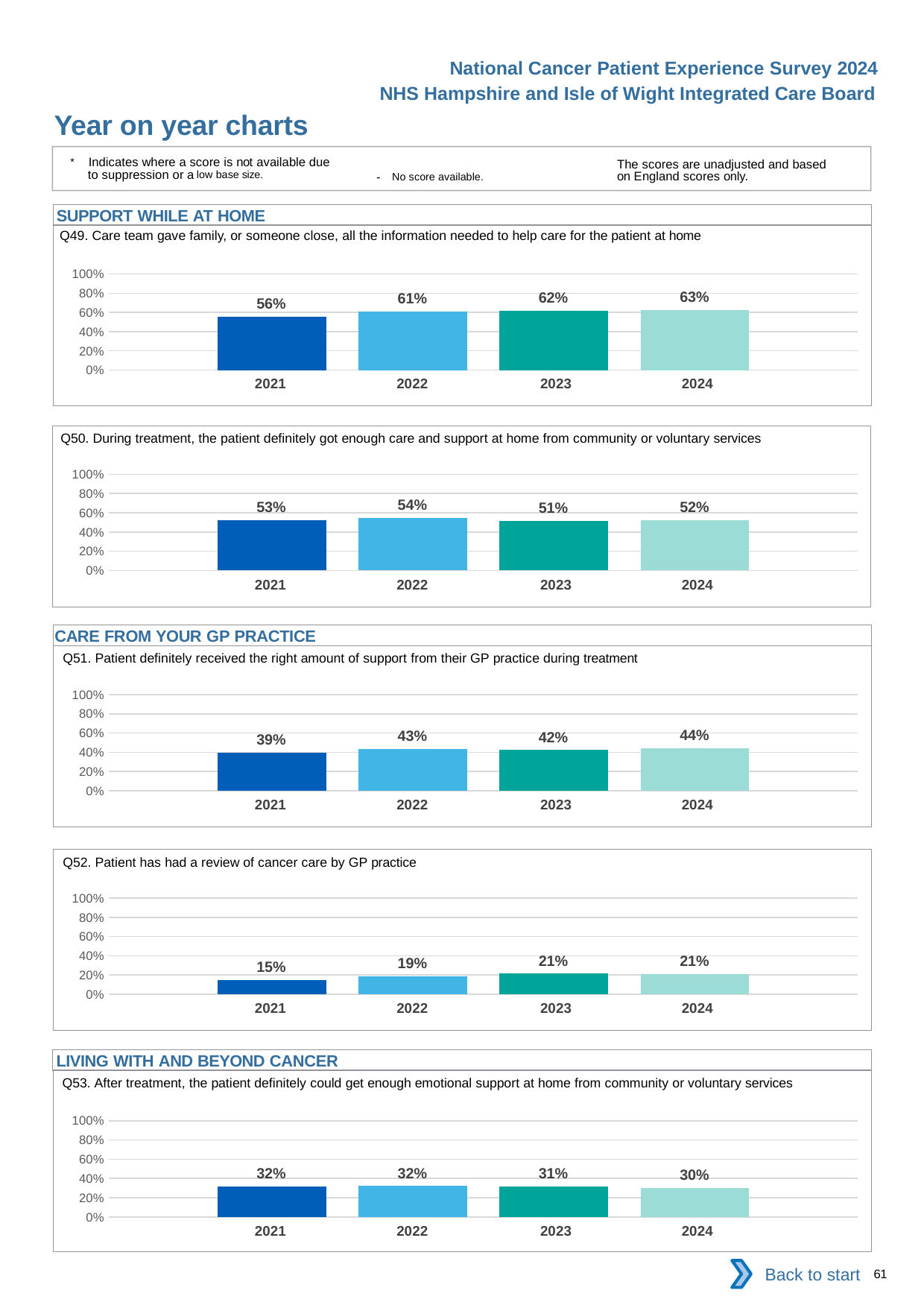
In the Q52 chart, is the value for 2022 greater or less than 20%? less In the Q52 chart, what is the value for 2021? 15% In the Q51 chart, what is the value for 2021? 39% What type of chart is used for Q52? Bar chart How many years are shown in the Q49 chart? 4 In the Q49 chart, which year has the lowest value? 2021 In the Q50 chart, which year has the highest value? 2022 In the Q51 chart, is the value for 2024 larger than the value for 2023? Yes In the Q50 chart, what is the difference between the 2022 and 2023 values? 3% In the Q53 chart, what is the difference between the 2021 and 2024 values? 2% In the Q53 chart, do the values rise or fall from 2021 to 2024? Fall In the Q49 chart, what is the value for 2024? 63%